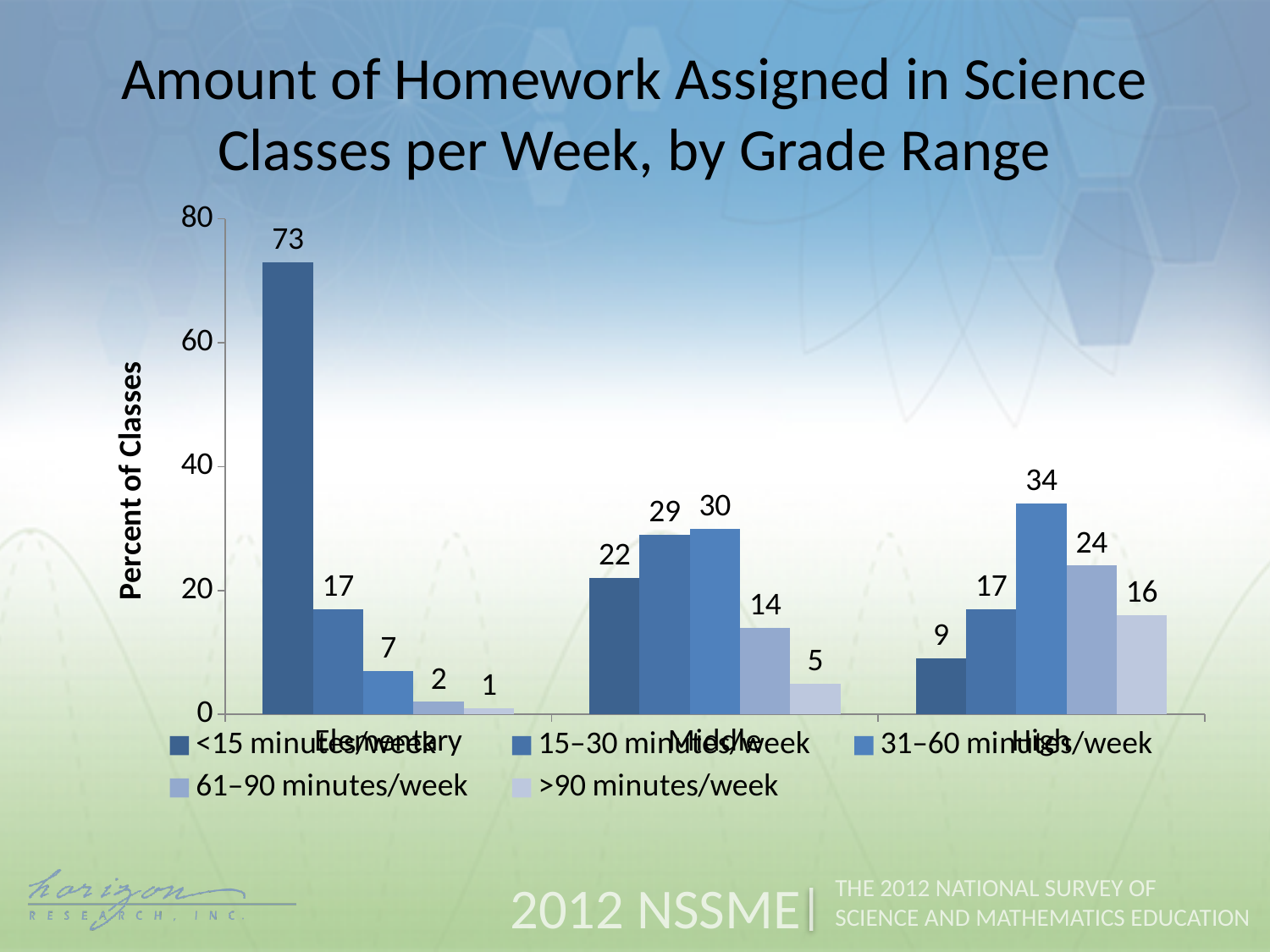
Which is larger: the percent of middle school classes assigned 15–30 minutes/week or the percent assigned 61–90 minutes/week? 15–30 minutes/week What percent of elementary science classes are assigned less than 15 minutes of homework per week? 73 What is the label of the y axis? Percent of Classes What is the difference between the percent of elementary classes and the percent of high school classes assigned less than 15 minutes of homework per week? 64 What kind of chart is shown on the slide? Bar chart Is the value for elementary classes assigned less than 15 minutes/week greater or less than 60? greater How many grade ranges are shown on the x axis? 3 What percent of middle school science classes are assigned 61–90 minutes of homework per week? 14 What percent of high school science classes are assigned 31–60 minutes of homework per week? 34 Which grade range has the highest percent of classes assigned more than 90 minutes of homework per week? High Which homework amount has the lowest percent of classes in the Elementary grade range? >90 minutes/week How many series does the legend list? 5